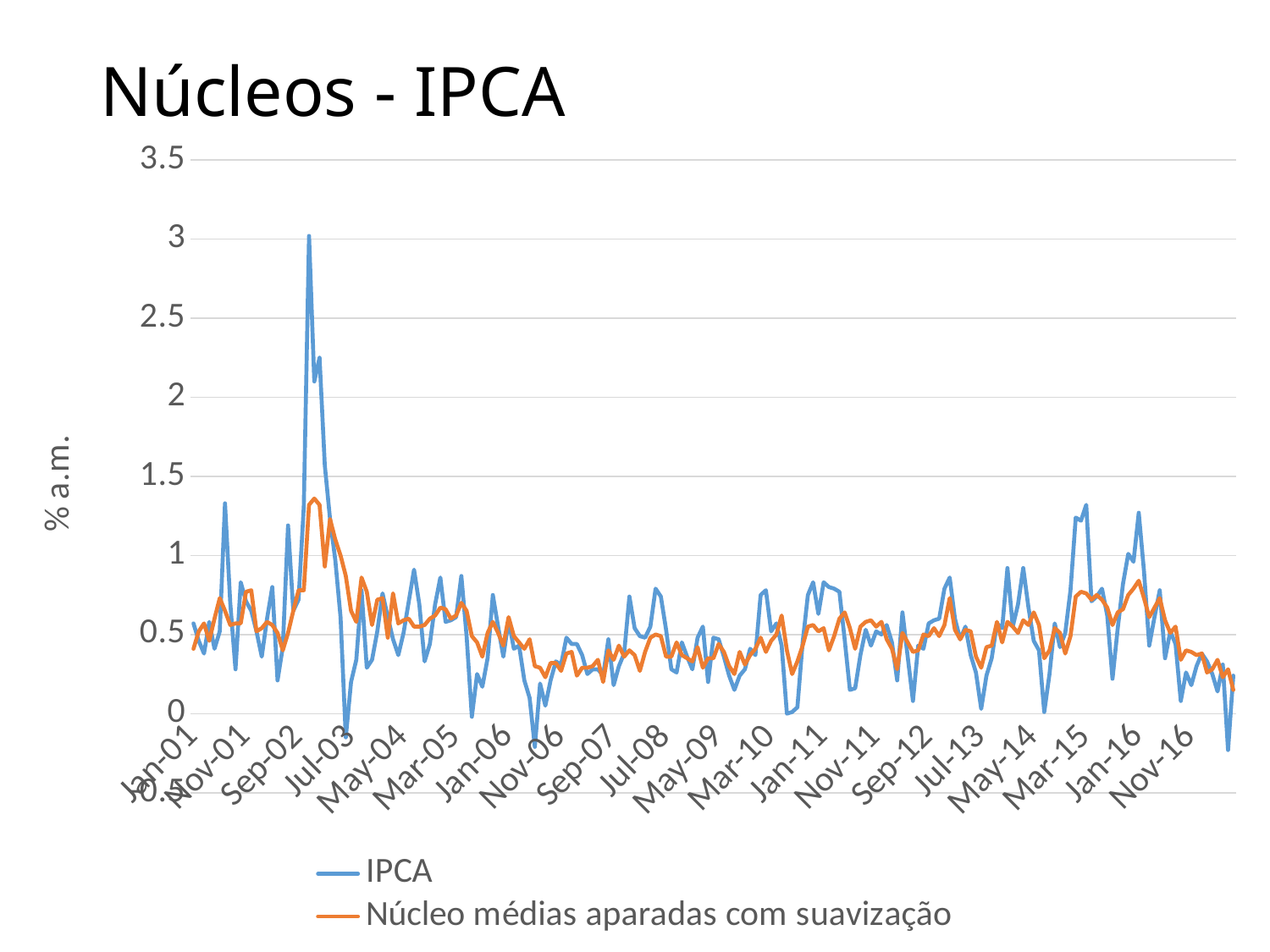
Is the highest value of the Núcleo médias aparadas com suavização series greater or less than 1? greater What is the highest value shown on the vertical axis? 3.5 How many series does the legend list? 2 Is the lowest value of the IPCA series greater or less than 0? less Which series reaches the highest peak on the chart? IPCA What kind of chart is shown on the slide? line chart Is the highest value of the Núcleo médias aparadas com suavização series greater or less than 1.5? less What is the label on the vertical axis? % a.m. Which series has the larger peak around early 2003, IPCA or Núcleo médias aparadas com suavização? IPCA How many date labels are shown along the horizontal axis? 20 What is the title of the chart? Núcleos - IPCA